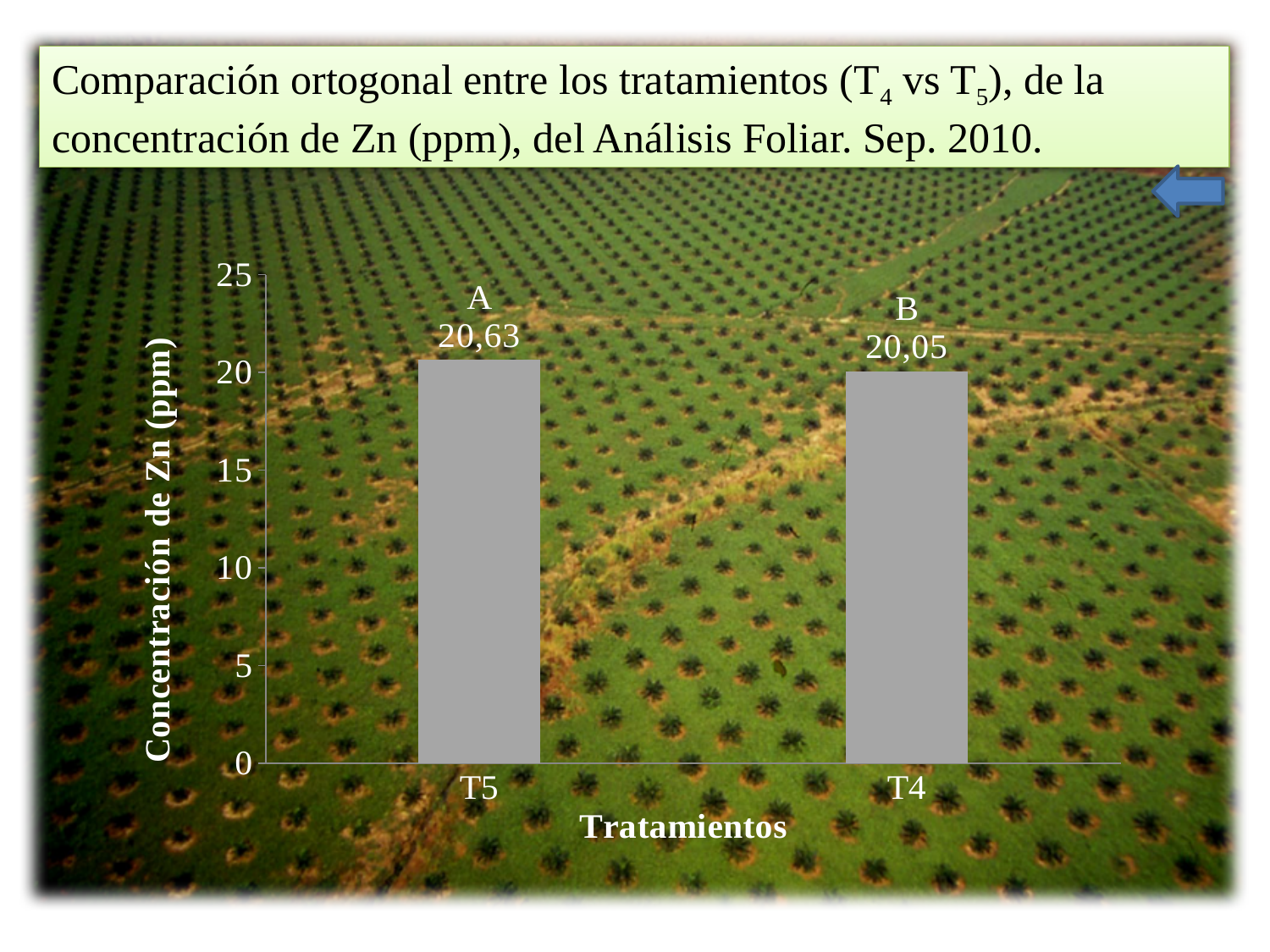
What is the difference between the Zn concentration of T5 and T4? 0,58 What kind of chart is shown on the slide? Bar chart Is the Zn concentration for T4 greater or less than 25? less What is the Zn concentration value shown for treatment T4? 20,05 What is the label of the y axis? Concentración de Zn (ppm) Which treatment has the lower Zn concentration? T4 What letter is printed above the bar for T4? B How many treatments are plotted on the chart? 2 What is the Zn concentration value shown for treatment T5? 20,63 What is the label of the x axis? Tratamientos Is the Zn concentration for T5 greater or less than 20? greater Which treatment has the higher Zn concentration? T5